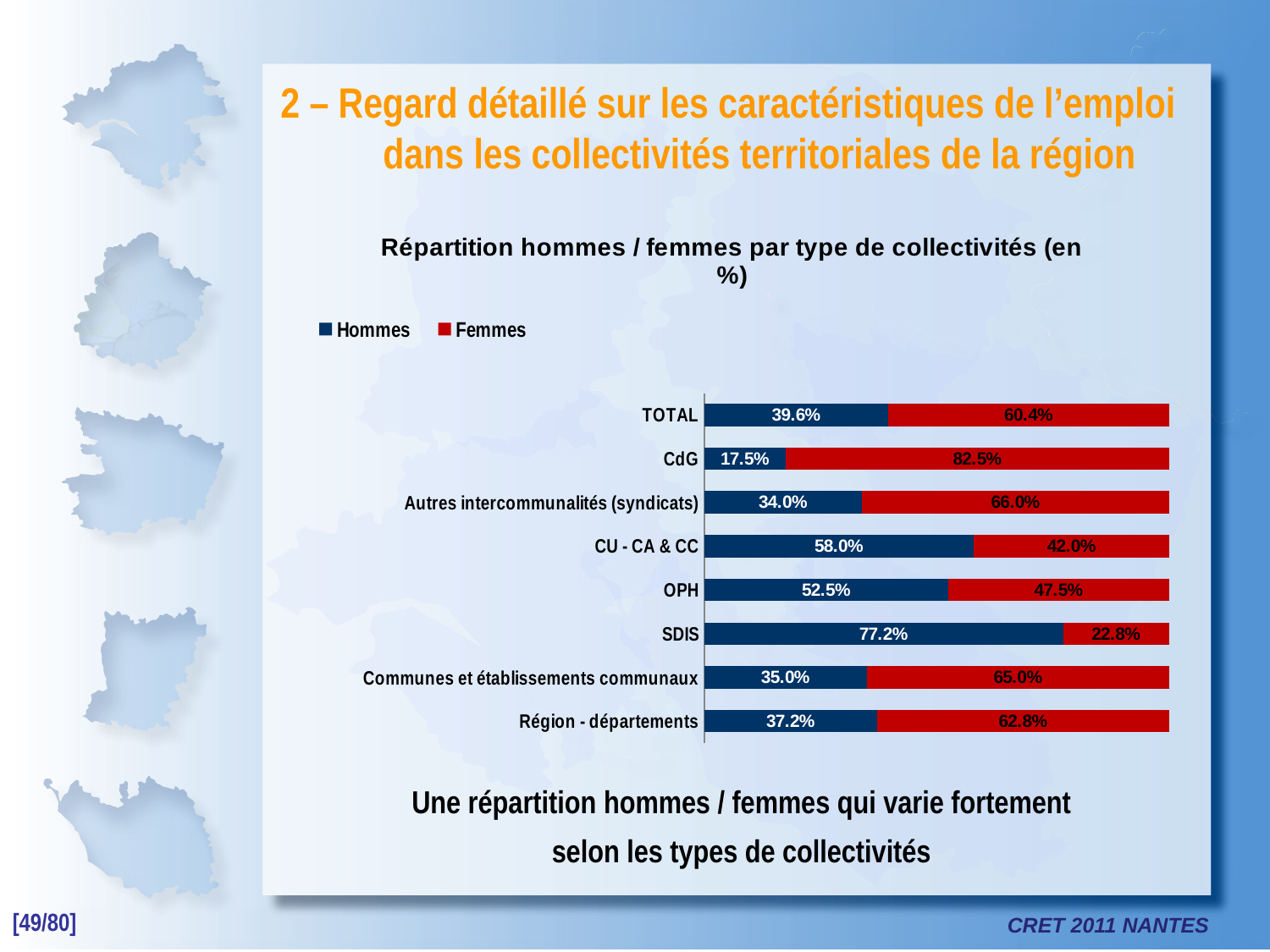
How many categories are shown on the chart? 8 What is the Hommes value for TOTAL? 39.6% What is the difference between the Femmes and Hommes values for OPH? 5.0% What is the Femmes value for Région - départements? 62.8% Which category has the lowest Hommes value? CdG Which is larger for CU - CA & CC, the Hommes value or the Femmes value? Hommes What is the total of the stacked bar for Communes et établissements communaux? 100.0% What kind of chart is shown on the slide? Stacked bar chart What is the Hommes value for SDIS? 77.2% How many series does the legend list? 2 What is the Femmes value for CdG? 82.5% Which category has the highest Hommes value? SDIS